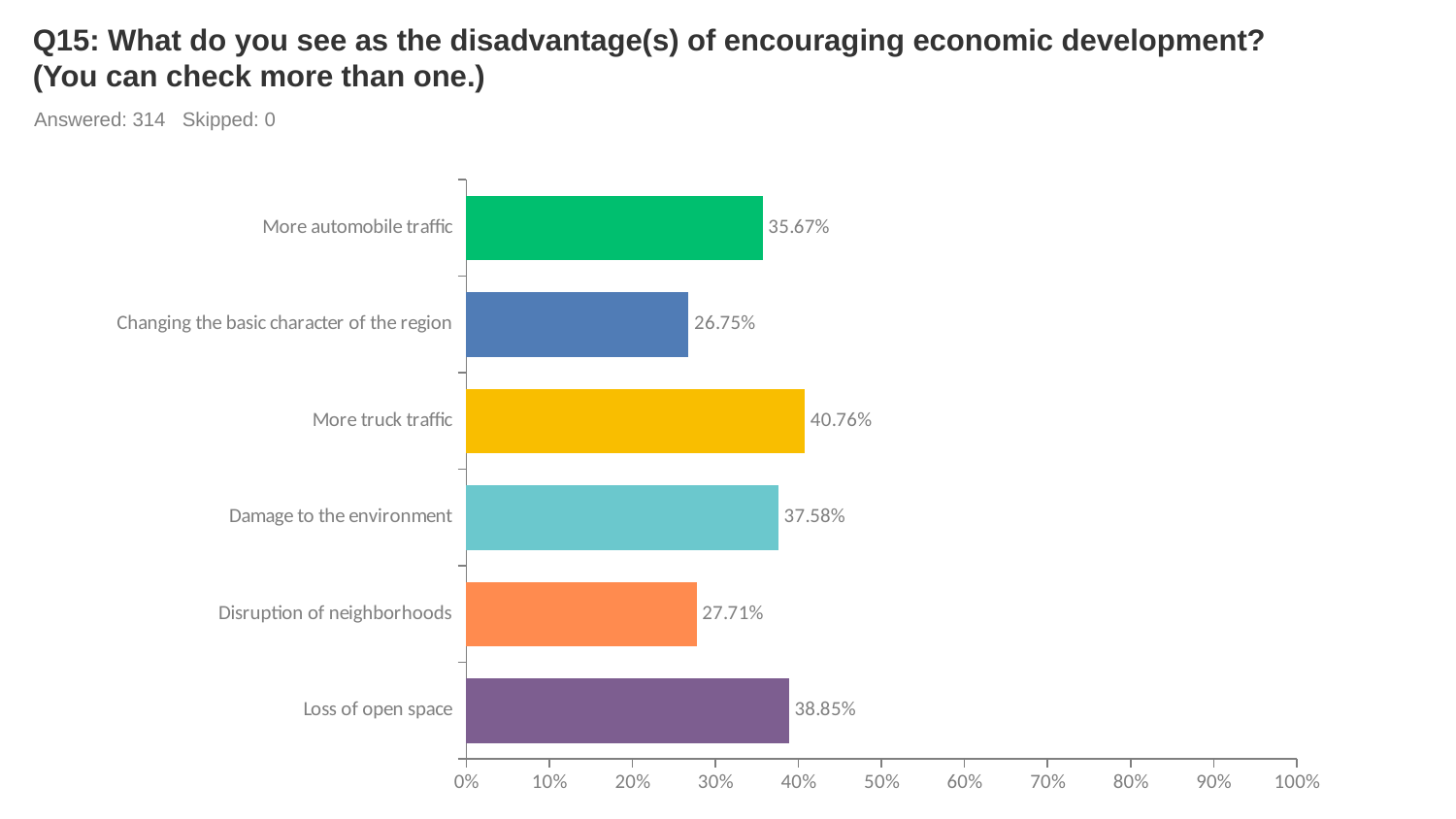
Which category has the lowest percentage? Changing the basic character of the region What percentage of respondents selected "More truck traffic" as a disadvantage? 40.76% Which category has the highest percentage? More truck traffic What is the difference between "Damage to the environment" and "Disruption of neighborhoods"? 9.87% What is the difference between the percentages for "More truck traffic" and "More automobile traffic"? 5.09% Is the value for "Disruption of neighborhoods" greater or less than 30%? less Which is larger, the value for "Loss of open space" or the value for "Damage to the environment"? Loss of open space What is the value shown for "Loss of open space"? 38.85% What kind of chart is shown on the slide? Bar chart How many categories are shown in the chart? 6 What percentage is shown for "Changing the basic character of the region"? 26.75% How many respondents answered this question according to the slide? 314